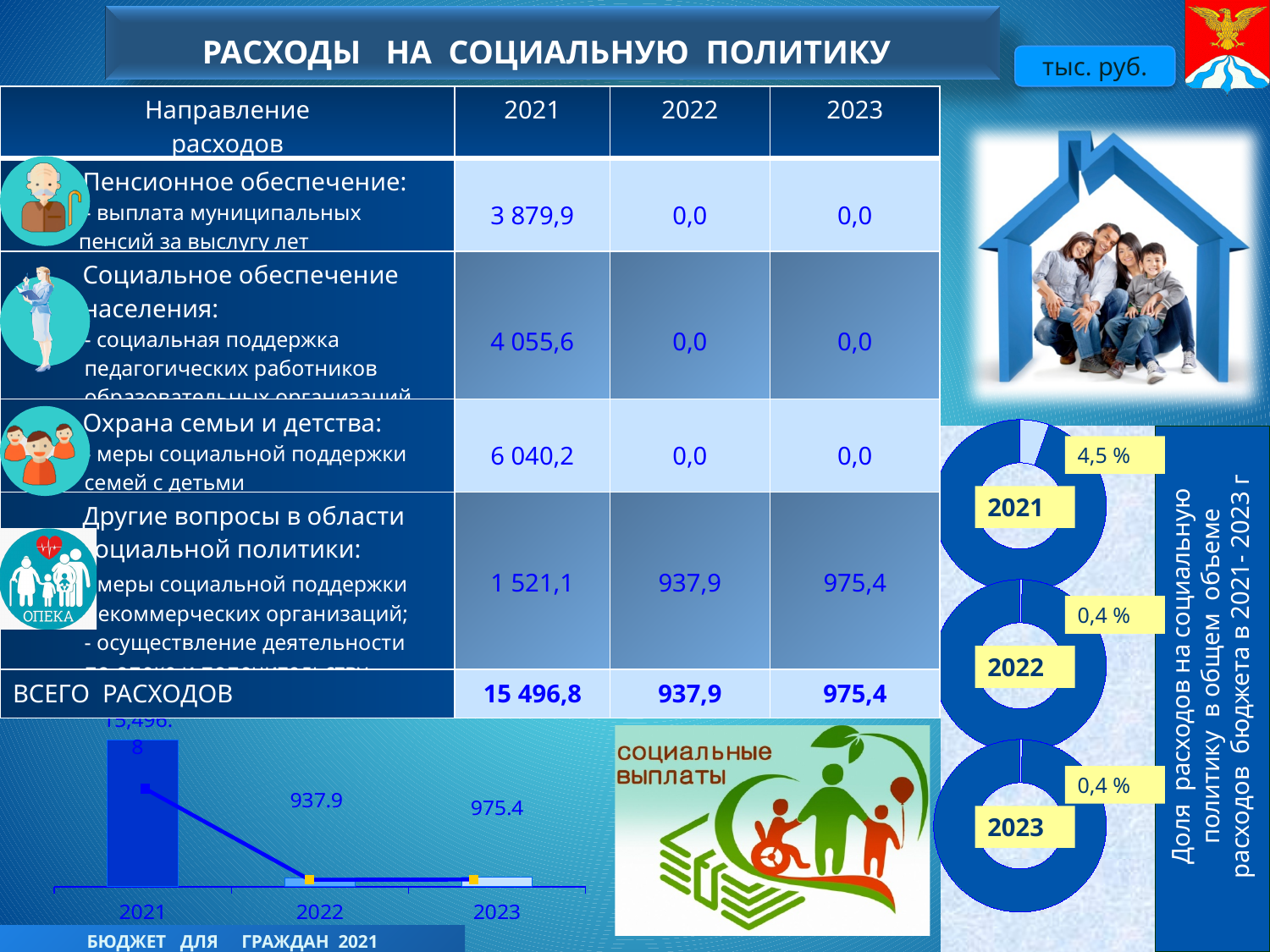
In the bar chart at the bottom left, which is larger, the value for 2022 or the value for 2023? 2023 In the bar chart at the bottom left, which year has the lowest value? 2022 In the bar chart at the bottom left, do the values rise or fall from 2021 to 2022? fall Among the three donut charts on the right, which year shows the highest share? 2021 In the donut chart labelled 2021 on the right, what share is shown? 4,5 % How many years are shown on the x axis of the bar chart at the bottom left? 3 In the donut chart labelled 2023 on the right, what share is shown? 0,4 % What kind of chart is shown at the bottom left of the slide? bar chart In the bar chart at the bottom left, what is the value for 2023? 975.4 In the bar chart at the bottom left, what is the value for 2022? 937.9 In the bar chart at the bottom left, what is the difference between the values for 2023 and 2022? 37.5 In the bar chart at the bottom left, which year has the highest value? 2021